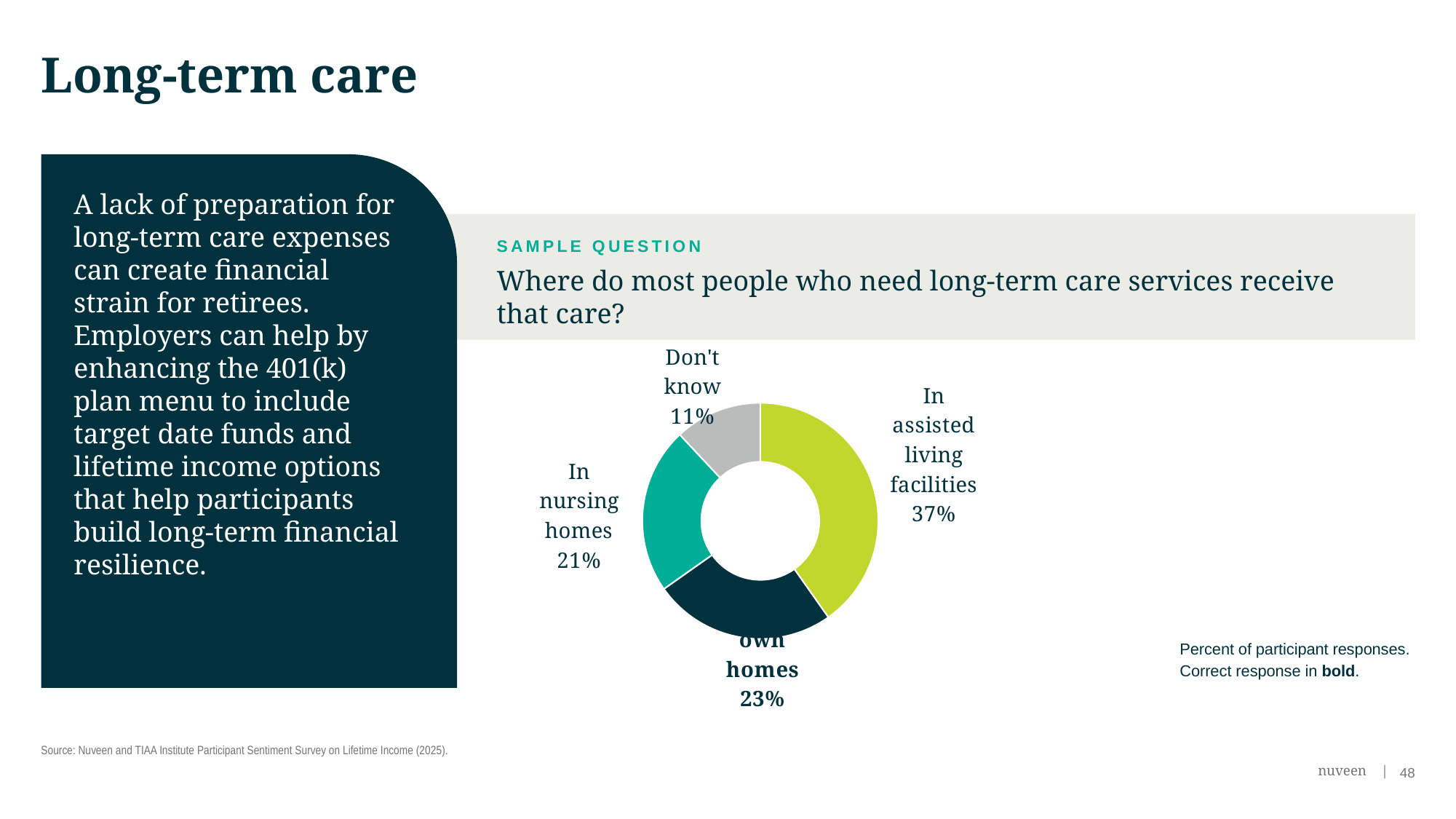
What kind of chart is shown on the slide? Donut (pie) chart What percentage of participants answered "In assisted living facilities"? 37% What is the combined percentage of "In assisted living facilities" and "Don't know"? 48% Which response received the smallest share of participants? Don't know What percentage of participants answered "Don't know"? 11% What percentage of participants answered "In nursing homes"? 21% Which response received the largest share of participants? In assisted living facilities What is the difference in percentage points between "In assisted living facilities" and "In nursing homes"? 16 What percentage of participants answered "own homes"? 23% How many response categories are shown in the chart? 4 Which response is marked as the correct answer (shown in bold)? own homes (23%) Which response has a larger share: "In nursing homes" or "Don't know"? In nursing homes